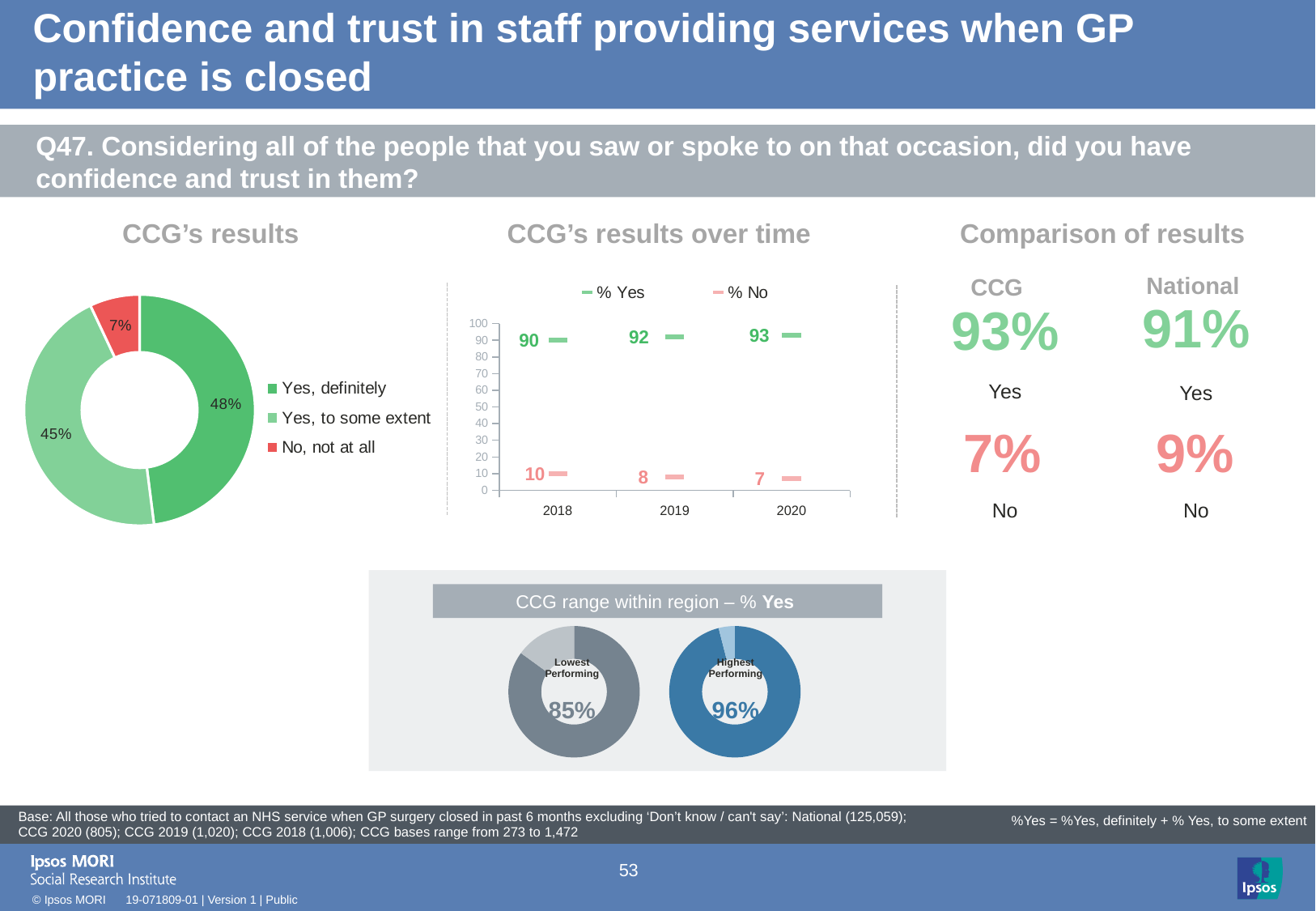
In the 'CCG's results over time' chart, what is the % No value for 2018? 10 In the 'CCG's results over time' chart, what is the difference between the % Yes values for 2020 and 2018? 3 In the 'CCG's results over time' chart, how many series does the legend list? 2 In the 'CCG's results' chart, what percentage is shown for 'No, not at all'? 7% In the 'CCG range within region – % Yes' section, what is the value for the highest performing CCG? 96% In the 'CCG's results' chart, what percentage is shown for 'Yes, definitely'? 48% In the 'CCG's results' chart, which category has the smallest share? No, not at all In the 'CCG's results over time' chart, does the % Yes series rise or fall from 2018 to 2020? rise In the 'CCG's results' chart, how many categories does the legend list? 3 In the 'CCG's results' chart, what is the difference between the 'Yes, definitely' and 'Yes, to some extent' shares? 3% In the 'CCG's results' chart, which category has the largest share? Yes, definitely In the 'CCG's results over time' chart, what is the % Yes value for 2019? 92